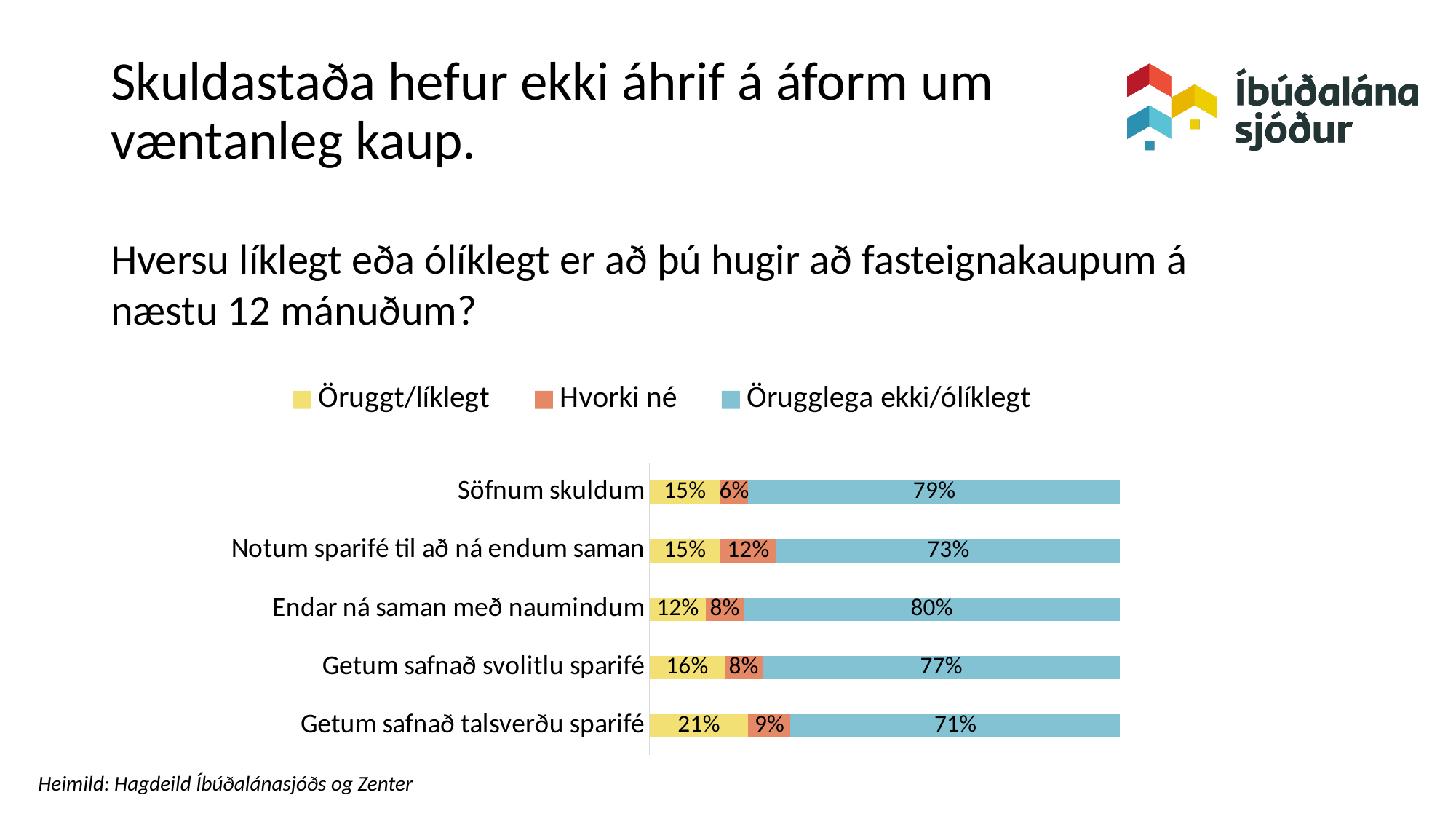
Which category has the highest 'Öruggt/líklegt' value? Getum safnað talsverðu sparifé What kind of chart is shown on the slide? Stacked bar chart Which category has the highest 'Örugglega ekki/ólíklegt' value? Endar ná saman með naumindum What is the total of the stacked bar for 'Söfnum skuldum'? 100% What percentage of the 'Söfnum skuldum' group answered 'Örugglega ekki/ólíklegt'? 79% What is the 'Öruggt/líklegt' value for 'Getum safnað talsverðu sparifé'? 21% How many categories are shown in the chart? 5 How many series does the legend list? 3 What is the difference between the 'Örugglega ekki/ólíklegt' values for 'Endar ná saman með naumindum' and 'Getum safnað talsverðu sparifé'? 9% Which category has the lowest 'Hvorki né' value? Söfnum skuldum What is the 'Hvorki né' value for 'Notum sparifé til að ná endum saman'? 12% Which is larger: the 'Öruggt/líklegt' value for 'Getum safnað svolitlu sparifé' or for 'Endar ná saman með naumindum'? Getum safnað svolitlu sparifé